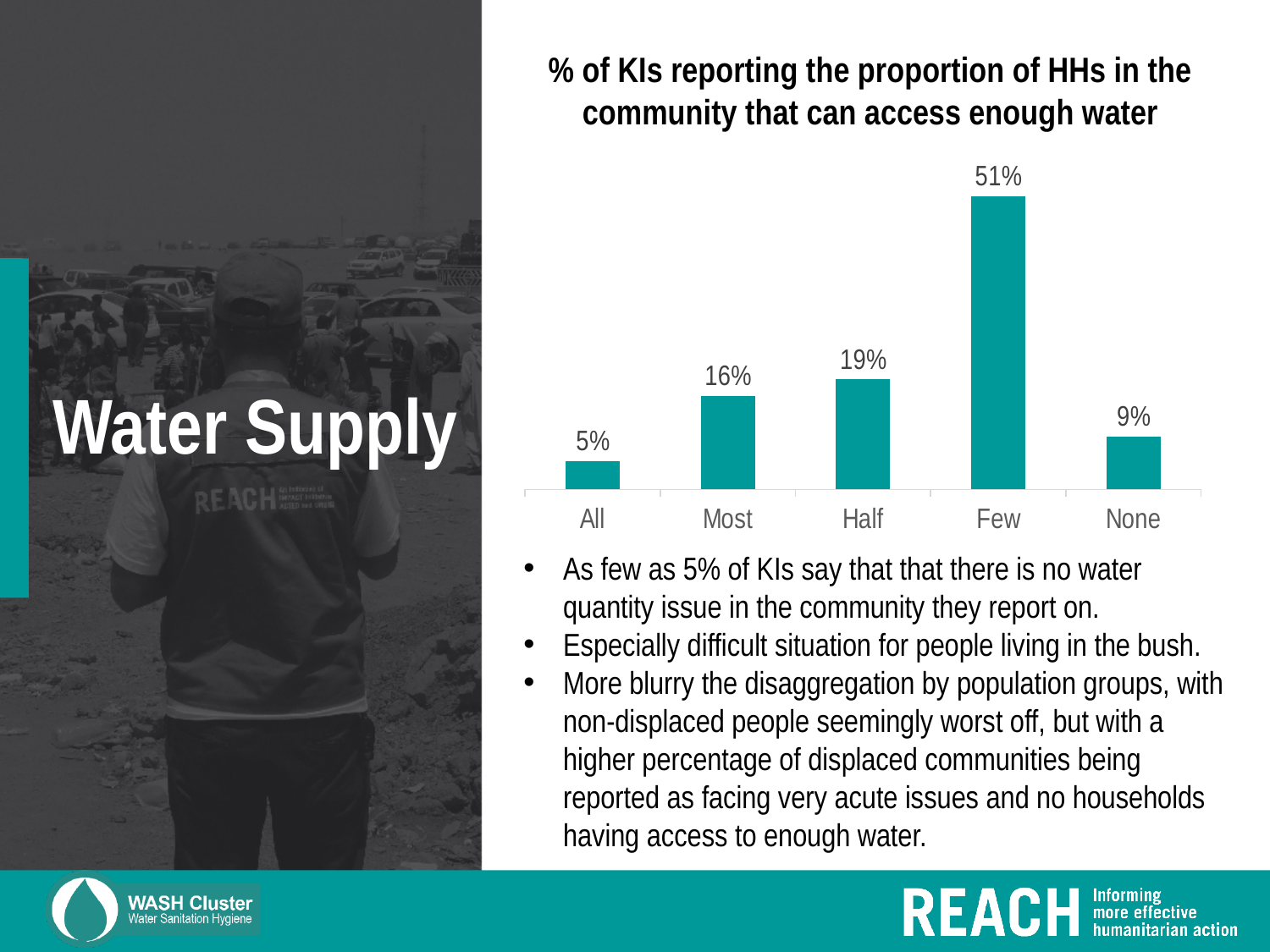
What is the difference between the values for 'Few' and 'Most'? 35% What is the difference between the values for 'None' and 'All'? 4% What is the value shown for the 'All' category? 5% What type of chart is shown on the slide? Bar chart Which category has the highest value? Few What percentage is shown for the 'Half' category? 19% Which is larger, the value for 'Half' or the value for 'Most'? Half What is the value for the 'None' category? 9% Which category has the lowest value? All What percentage of KIs reported that 'Few' households in the community can access enough water? 51% How many categories are shown on the x axis of the chart? 5 What is the title of the chart? % of KIs reporting the proportion of HHs in the community that can access enough water